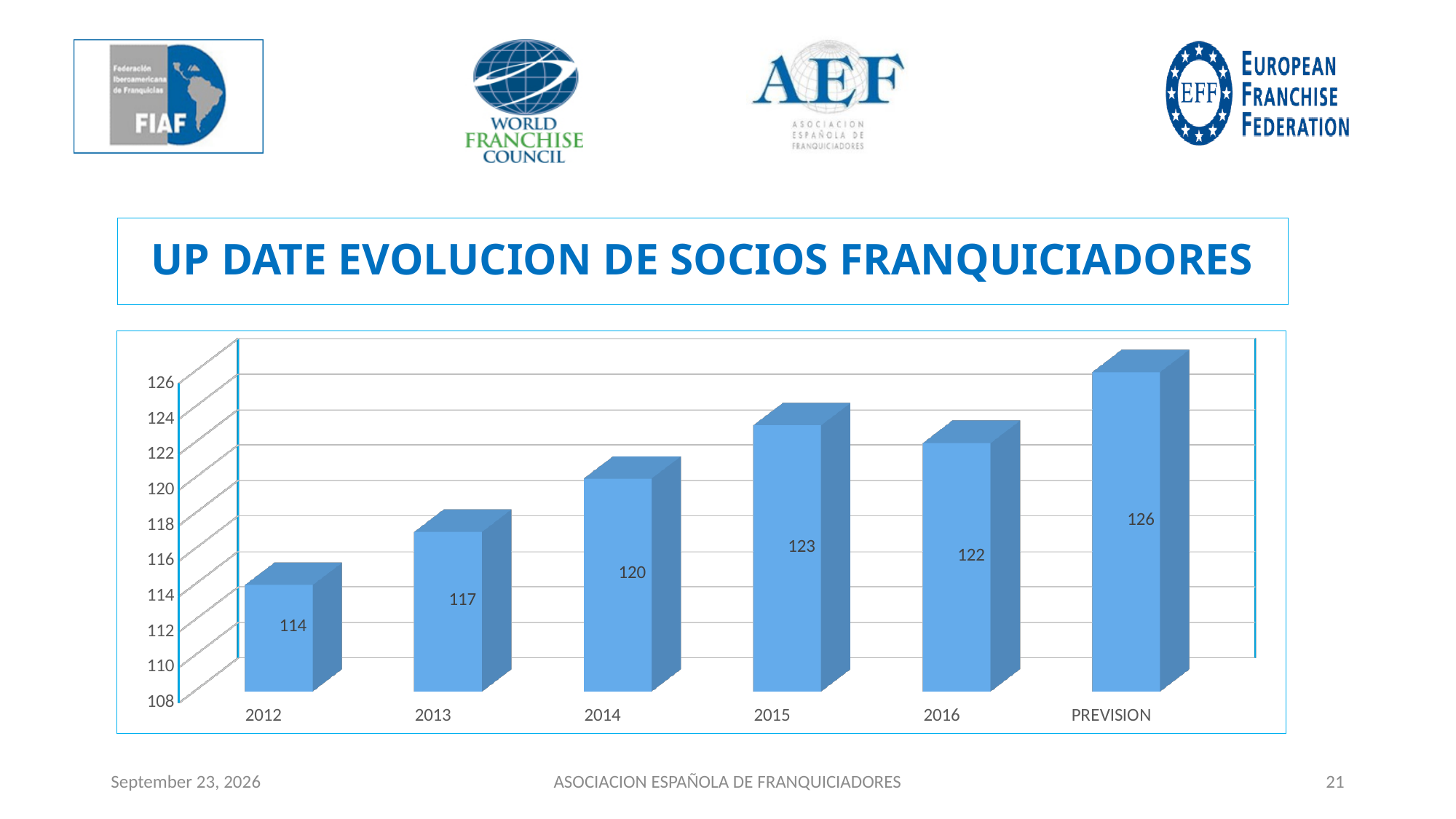
What is the value for 2014? 120 What is the value for PREVISION? 126 Which category has the highest value? PREVISION What is the difference between the values for 2015 and 2016? 1 What is the difference between the values for PREVISION and 2012? 12 Which is larger, the value for 2015 or the value for 2016? 2015 How many categories are shown on the x axis? 6 Do the values rise or fall from 2012 to 2015? rise Which category has the lowest value? 2012 Is the value for 2013 greater or less than 120? less What kind of chart is shown on the slide? bar chart What is the value for 2012? 114